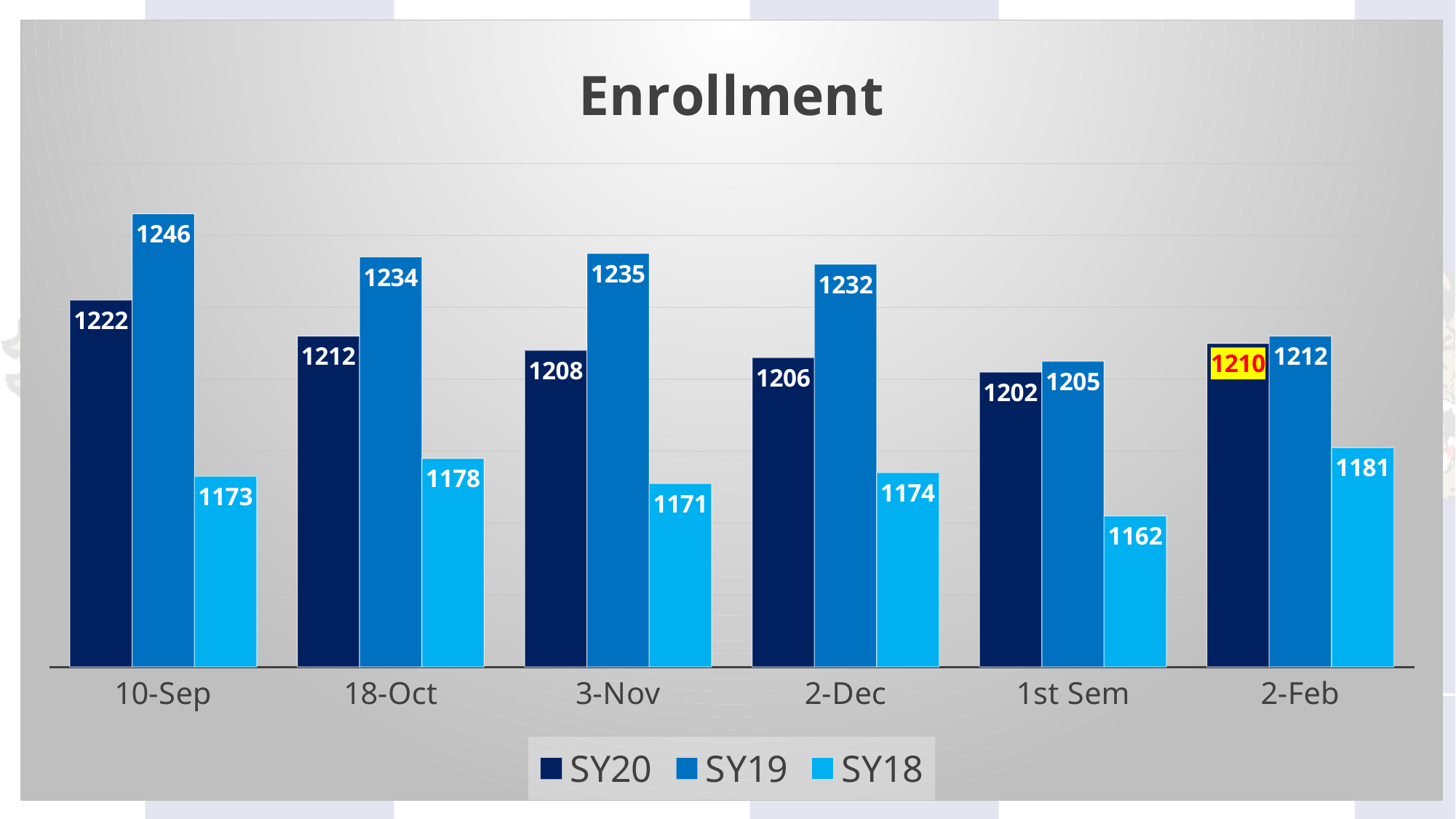
What is the difference between the SY19 and SY20 values for 18-Oct? 22 Which category has the highest SY19 value? 10-Sep Which category has the lowest SY18 value? 1st Sem How many series does the legend list? 3 What kind of chart is shown? bar chart Do the SY20 values rise or fall from 10-Sep to 1st Sem? fall How many categories are shown on the x axis? 6 What is the SY20 enrollment value for 10-Sep? 1222 What is the title of the chart? Enrollment What is the SY19 enrollment value for 2-Dec? 1232 What is the SY18 enrollment value for 1st Sem? 1162 Which is larger for 2-Feb, the SY20 value or the SY18 value? SY20